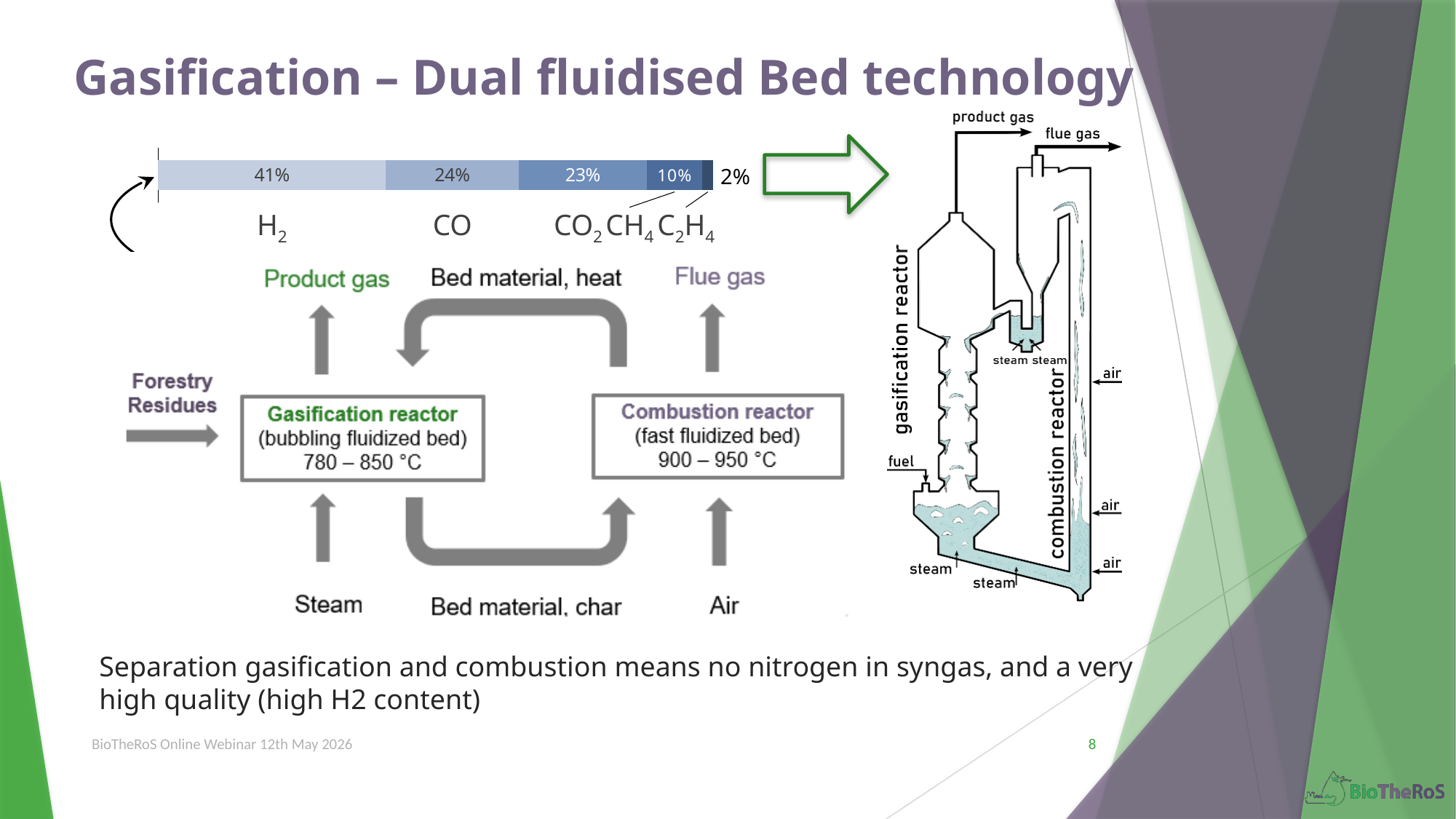
Which has the larger share in the stacked bar chart, CO or CO2? CO What share of the product gas is C2H4 in the stacked bar chart? 2% What is the total of all segments in the product gas stacked bar? 100% What is the difference between the H2 share and the CO share in the stacked bar chart? 17% Which component has the smallest share in the product gas stacked bar chart? C2H4 What share of the product gas is CO in the stacked bar chart? 24% What share of the product gas is CH4 in the stacked bar chart? 10% What share of the product gas is H2 in the stacked bar chart? 41% What share of the product gas is CO2 in the stacked bar chart? 23% How many gas components are shown as segments in the stacked bar chart? 5 Which component has the largest share in the product gas stacked bar chart? H2 What kind of chart shows the product gas composition? Stacked bar chart